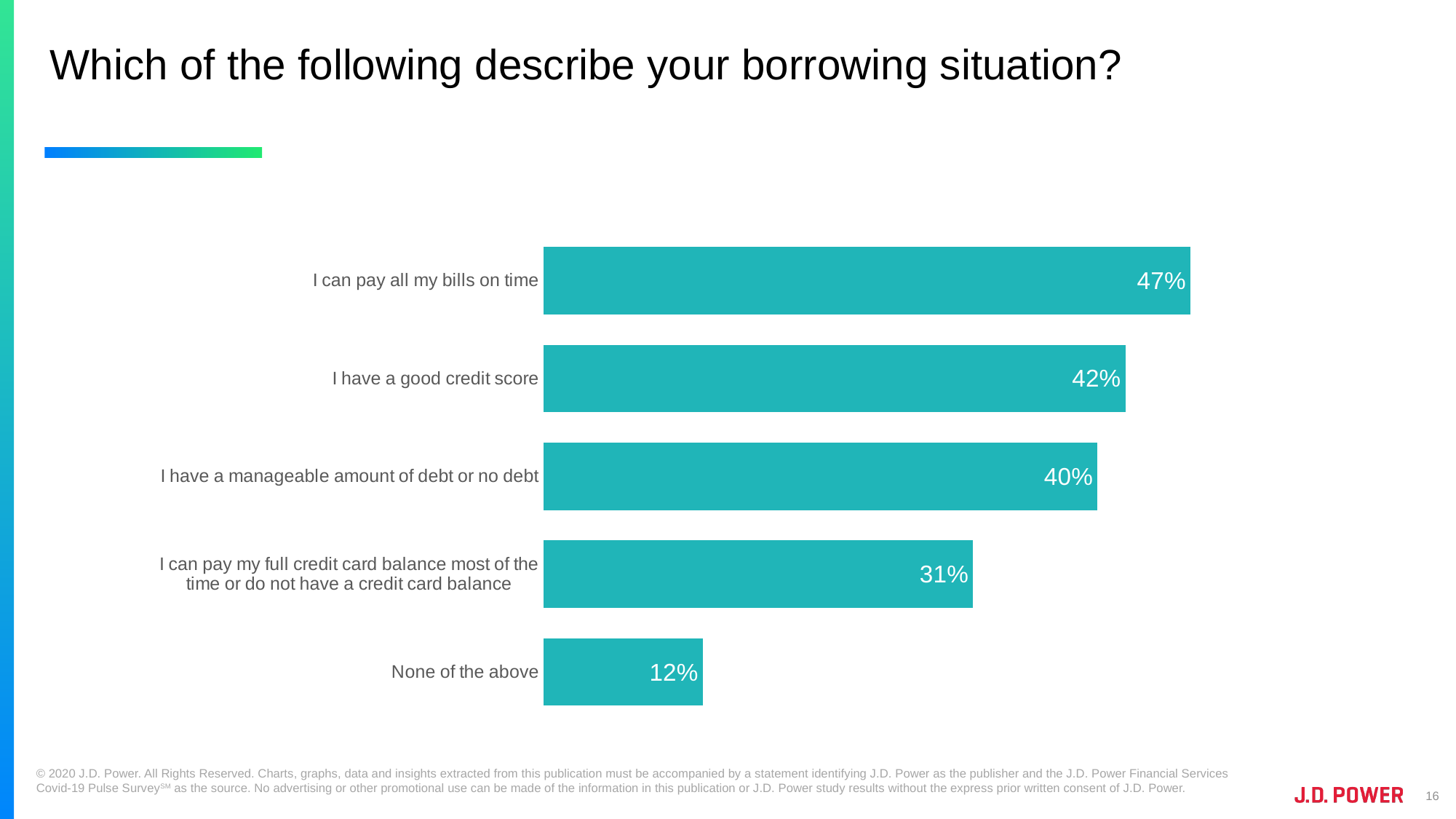
Which category has the highest value? I can pay all my bills on time Which is larger: "I have a good credit score" or "I have a manageable amount of debt or no debt"? I have a good credit score What percentage of respondents said "I can pay all my bills on time"? 47% What type of chart is shown on the slide? Bar chart Which category has the lowest value? None of the above What is the difference between "I can pay all my bills on time" and "I have a good credit score"? 5% What percentage chose "None of the above"? 12% What is the title of the slide? Which of the following describe your borrowing situation? How many categories are shown in the chart? 5 What is the value for "I can pay my full credit card balance most of the time or do not have a credit card balance"? 31% What is the value for "I have a good credit score"? 42% What is the difference between "I have a manageable amount of debt or no debt" and "None of the above"? 28%